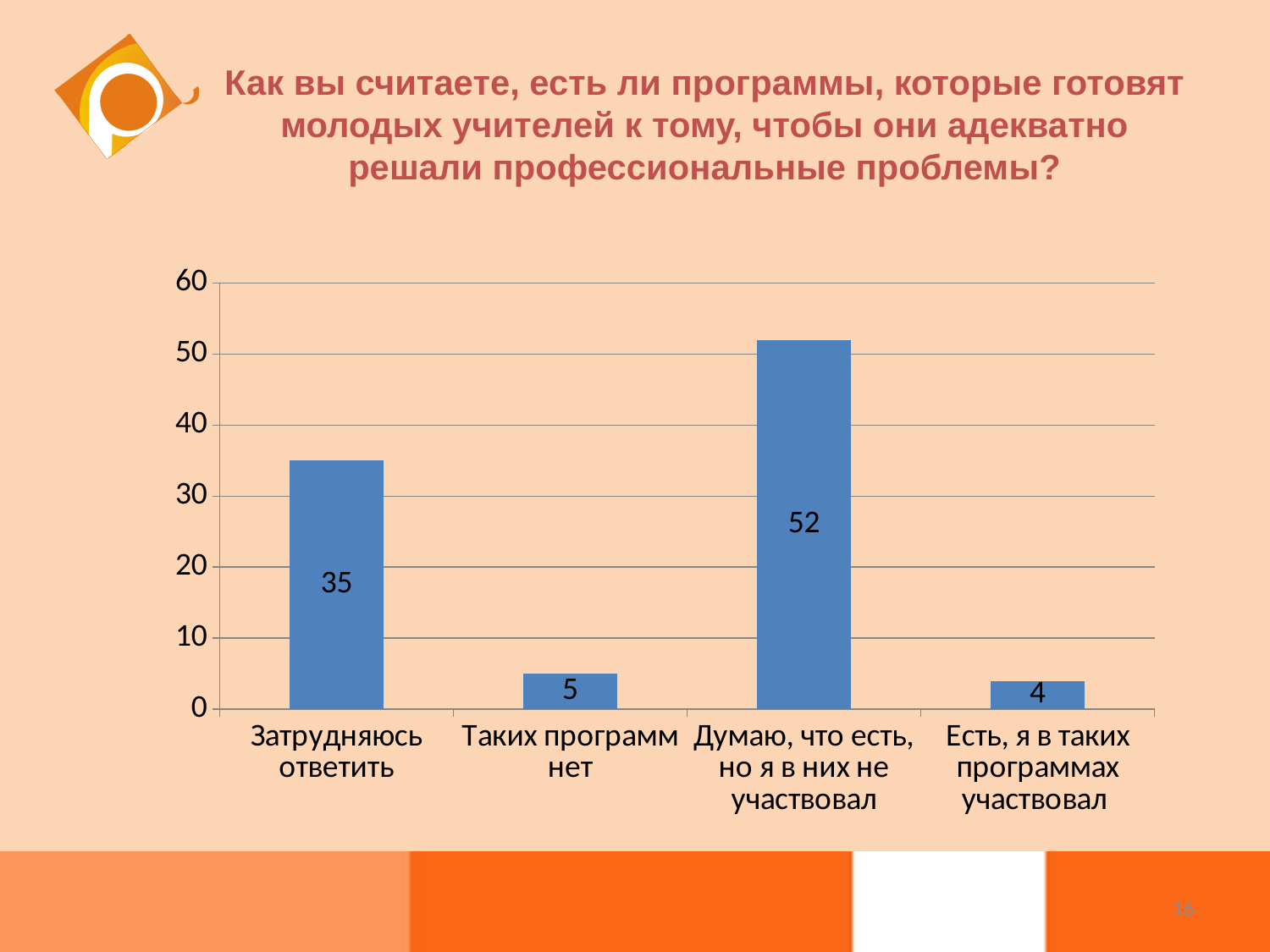
How many categories are shown on the x axis? 4 What is the value for "Таких программ нет"? 5 What is the value for "Есть, я в таких программах участвовал"? 4 Which category has the lowest value? Есть, я в таких программах участвовал What is the highest value shown on the vertical axis? 60 Is the value for "Думаю, что есть, но я в них не участвовал" greater or less than 50? greater What is the value for "Затрудняюсь ответить"? 35 Which is larger: the value for "Затрудняюсь ответить" or the value for "Таких программ нет"? Затрудняюсь ответить What is the difference between the values for "Думаю, что есть, но я в них не участвовал" and "Затрудняюсь ответить"? 17 What is the value for "Думаю, что есть, но я в них не участвовал"? 52 What kind of chart is shown on the slide? bar chart Which category has the highest value? Думаю, что есть, но я в них не участвовал